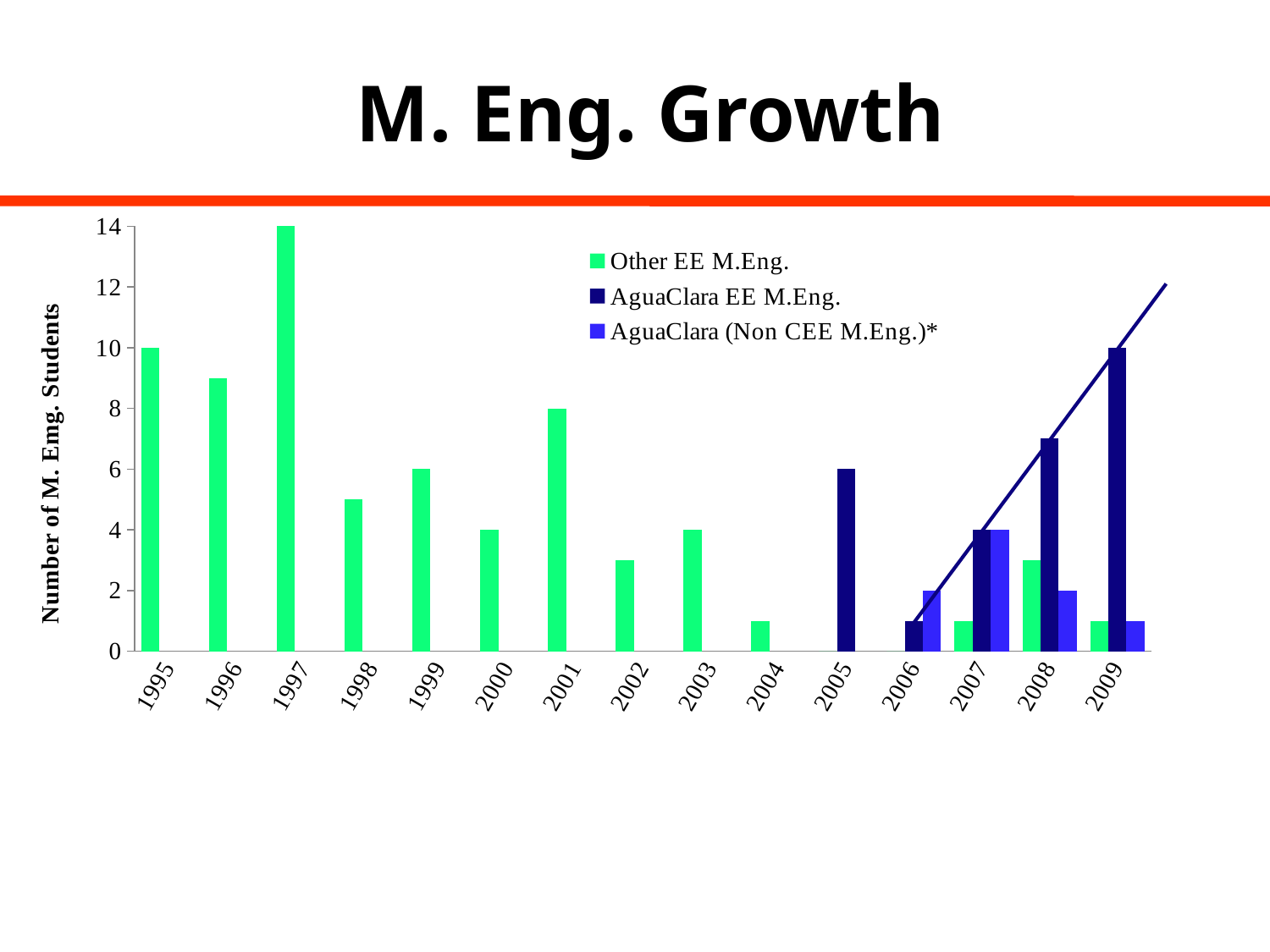
In which year is the Other EE M.Eng. value highest? 1997 What is the difference between the Other EE M.Eng. values for 1997 and 1995? 4 What is the value for Other EE M.Eng. in 1995? 10 What is the value for AguaClara EE M.Eng. in 2009? 10 Is the value for Other EE M.Eng. in 1996 greater or less than 8? greater What type of chart is shown on the slide? bar chart What is the label of the y axis? Number of M. Eng. Students How many series does the legend list? 3 How many years are shown on the x axis? 15 Which is larger, the AguaClara EE M.Eng. value in 2009 or in 2005? 2009 What is the value for AguaClara EE M.Eng. in 2005? 6 What is the value for Other EE M.Eng. in 1997? 14